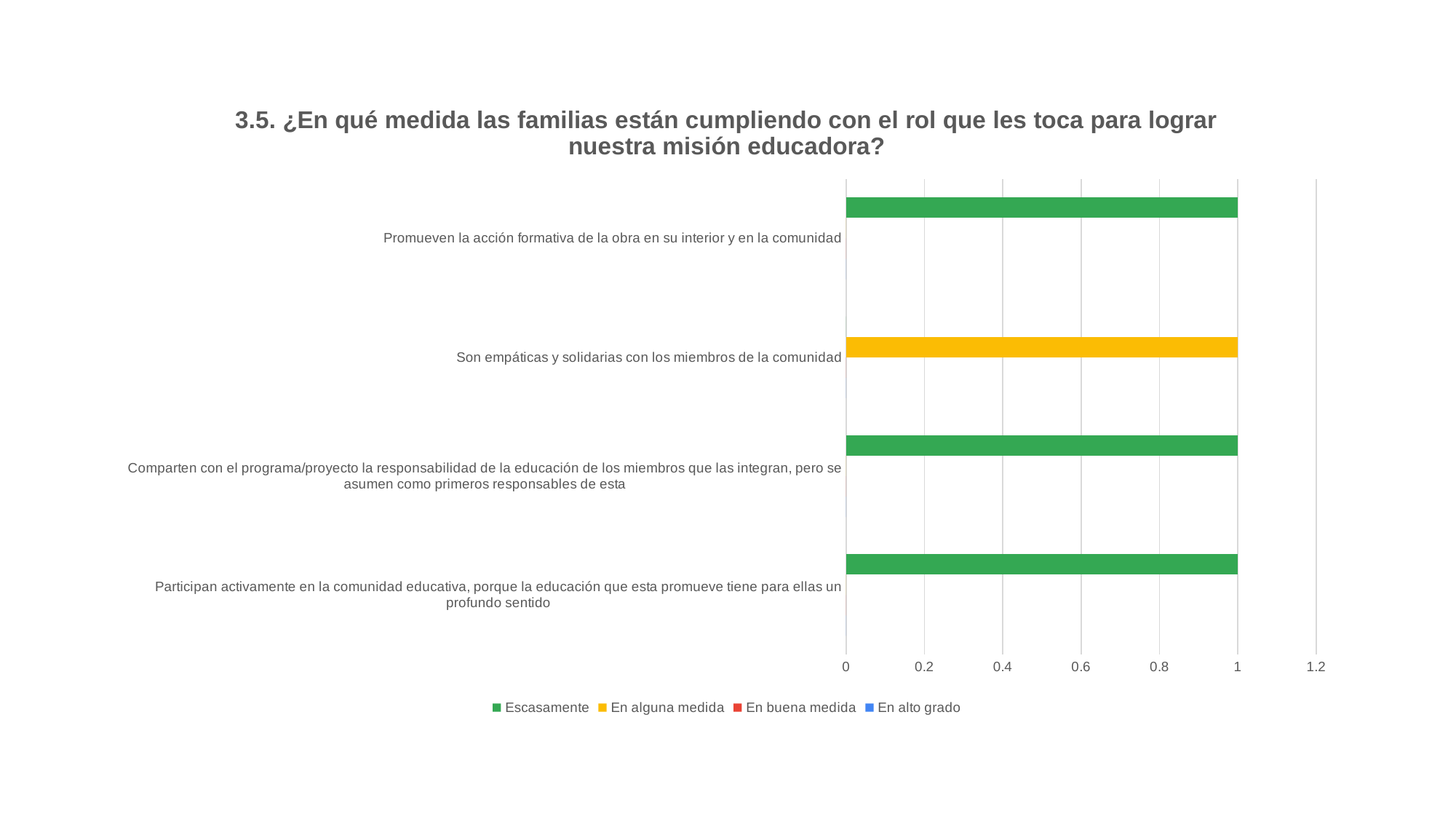
How many series does the legend list? 4 What is the value of the En alguna medida bar for 'Son empáticas y solidarias con los miembros de la comunidad'? 1 How many categories are plotted on the chart? 4 Which series has a visible bar for 'Son empáticas y solidarias con los miembros de la comunidad'? En alguna medida Is the En alguna medida value for 'Son empáticas y solidarias con los miembros de la comunidad' greater or less than 1.2? less What type of chart is shown on the slide? bar chart What is the value of the Escasamente bar for 'Promueven la acción formativa de la obra en su interior y en la comunidad'? 1 Is the Escasamente value for 'Comparten con el programa/proyecto la responsabilidad de la educación de los miembros que las integran, pero se asumen como primeros responsables de esta' greater or less than 0.8? greater How many categories have a visible Escasamente bar? 3 Which colour represents the series 'En alguna medida' in the legend? yellow What is the value of the Escasamente bar for 'Participan activamente en la comunidad educativa, porque la educación que esta promueve tiene para ellas un profundo sentido'? 1 What is the highest value shown on the x axis? 1.2